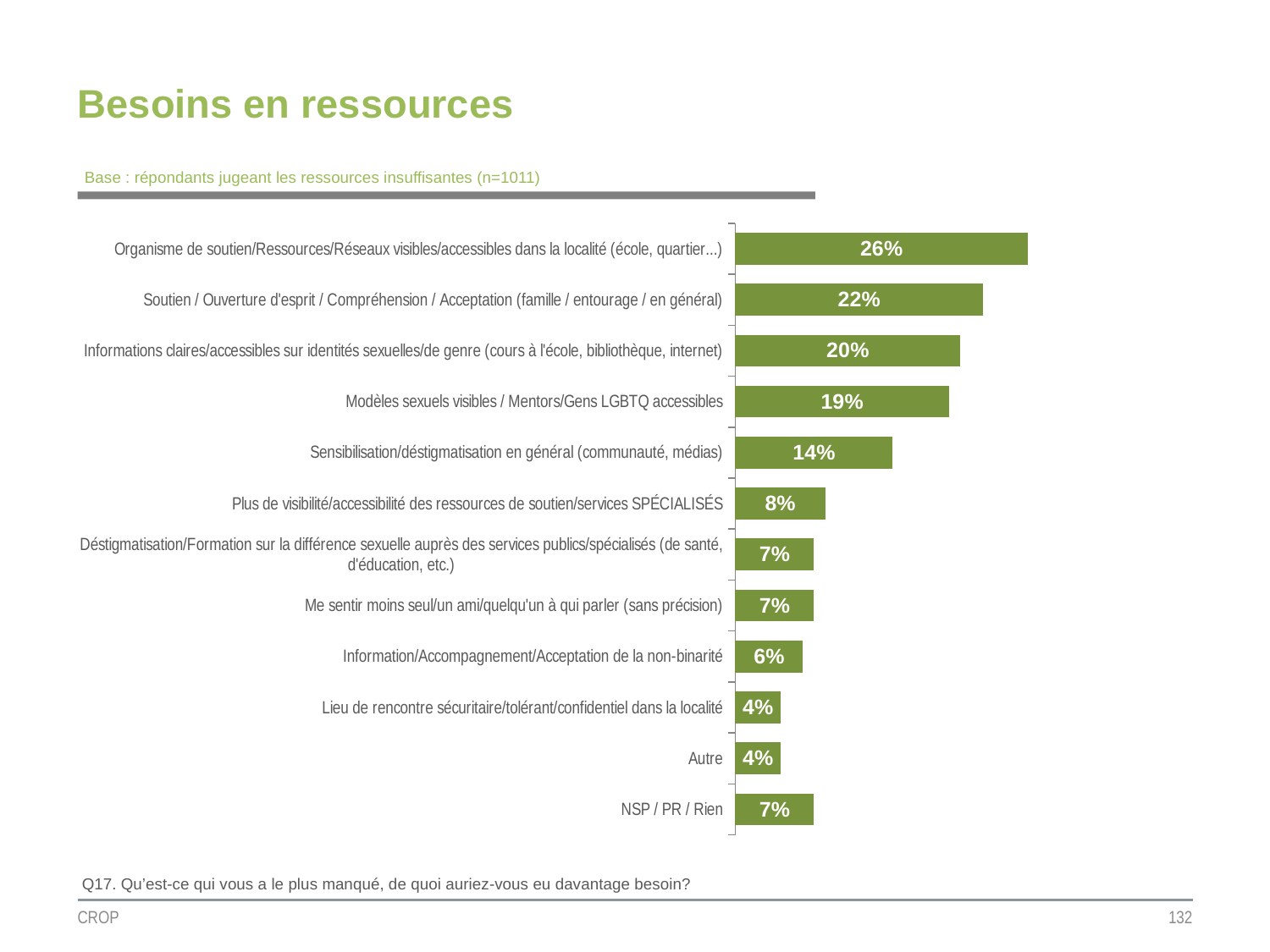
What is the difference between the values for "Soutien / Ouverture d'esprit / Compréhension / Acceptation (famille / entourage / en général)" and "Informations claires/accessibles sur identités sexuelles/de genre (cours à l'école, bibliothèque, internet)"? 2% What is the difference between the highest value and the value for "Autre"? 22% Which is larger: the value for "Plus de visibilité/accessibilité des ressources de soutien/services SPÉCIALISÉS" or the value for "Lieu de rencontre sécuritaire/tolérant/confidentiel dans la localité"? Plus de visibilité/accessibilité des ressources de soutien/services SPÉCIALISÉS What is the base described above the chart? Répondants jugeant les ressources insuffisantes (n=1011) Which category has the highest value? Organisme de soutien/Ressources/Réseaux visibles/accessibles dans la localité (école, quartier...) What kind of chart is shown on the slide? Bar chart What is the value of the highest bar? 26% How many categories are shown in the chart? 12 What value is shown for "NSP / PR / Rien"? 7% What value is shown for "Modèles sexuels visibles / Mentors/Gens LGBTQ accessibles"? 19% What value is shown for "Information/Accompagnement/Acceptation de la non-binarité"? 6% What value is shown for "Sensibilisation/déstigmatisation en général (communauté, médias)"? 14%